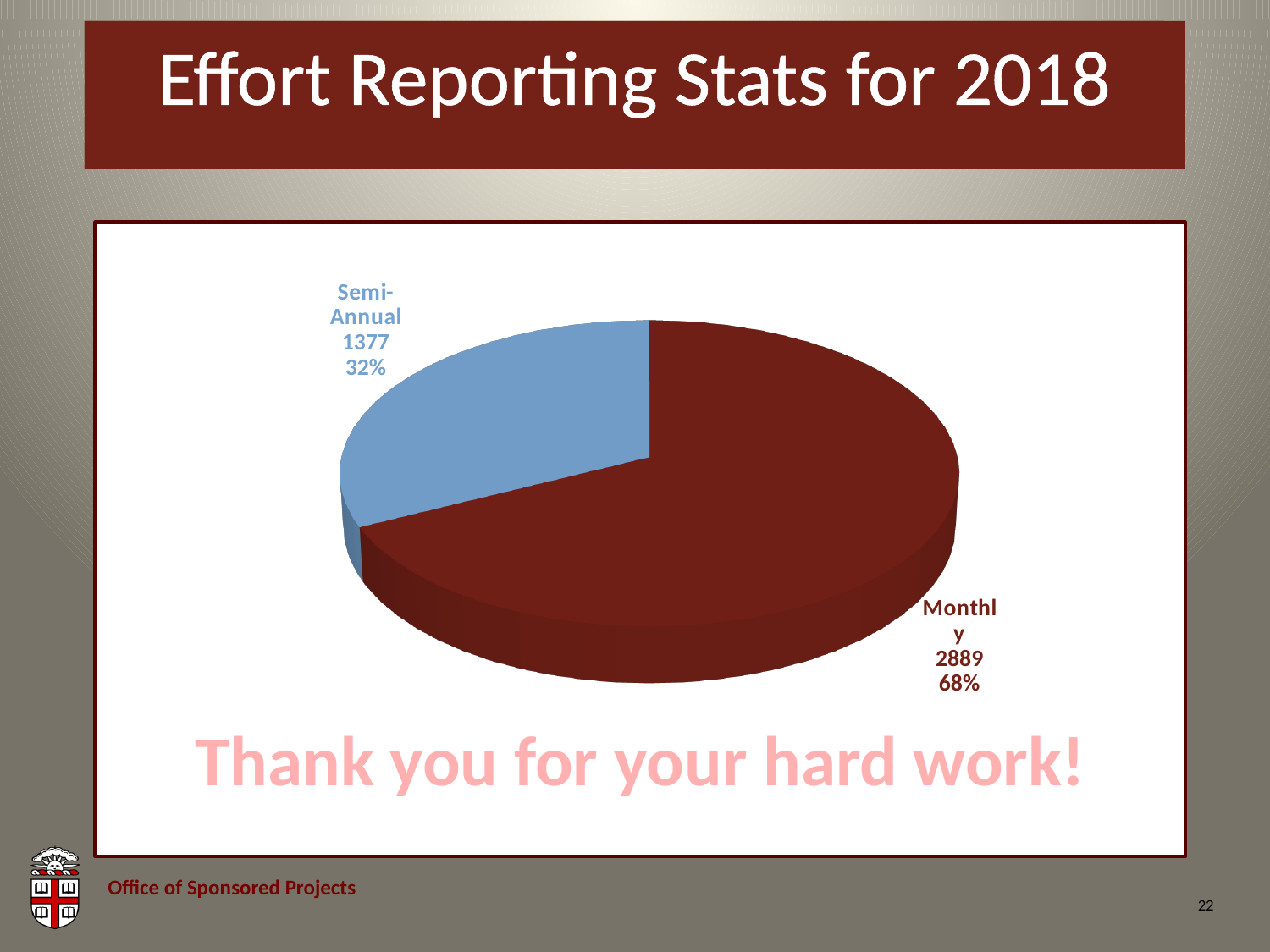
Which category has the smallest slice? Semi-Annual What share of the pie does the Monthly slice represent? 68% What share of the pie does the Semi-Annual slice represent? 32% What is the value for Semi-Annual? 1377 How many slices does the pie chart have? 2 What is the total of the two slices in the pie chart? 4266 What is the value for Monthly? 2889 What colour is the Semi-Annual slice? blue Which category has the largest slice? Monthly What is the difference between the Monthly and Semi-Annual values? 1512 What kind of chart is shown on the slide? pie chart Which is larger, the Monthly value or the Semi-Annual value? Monthly